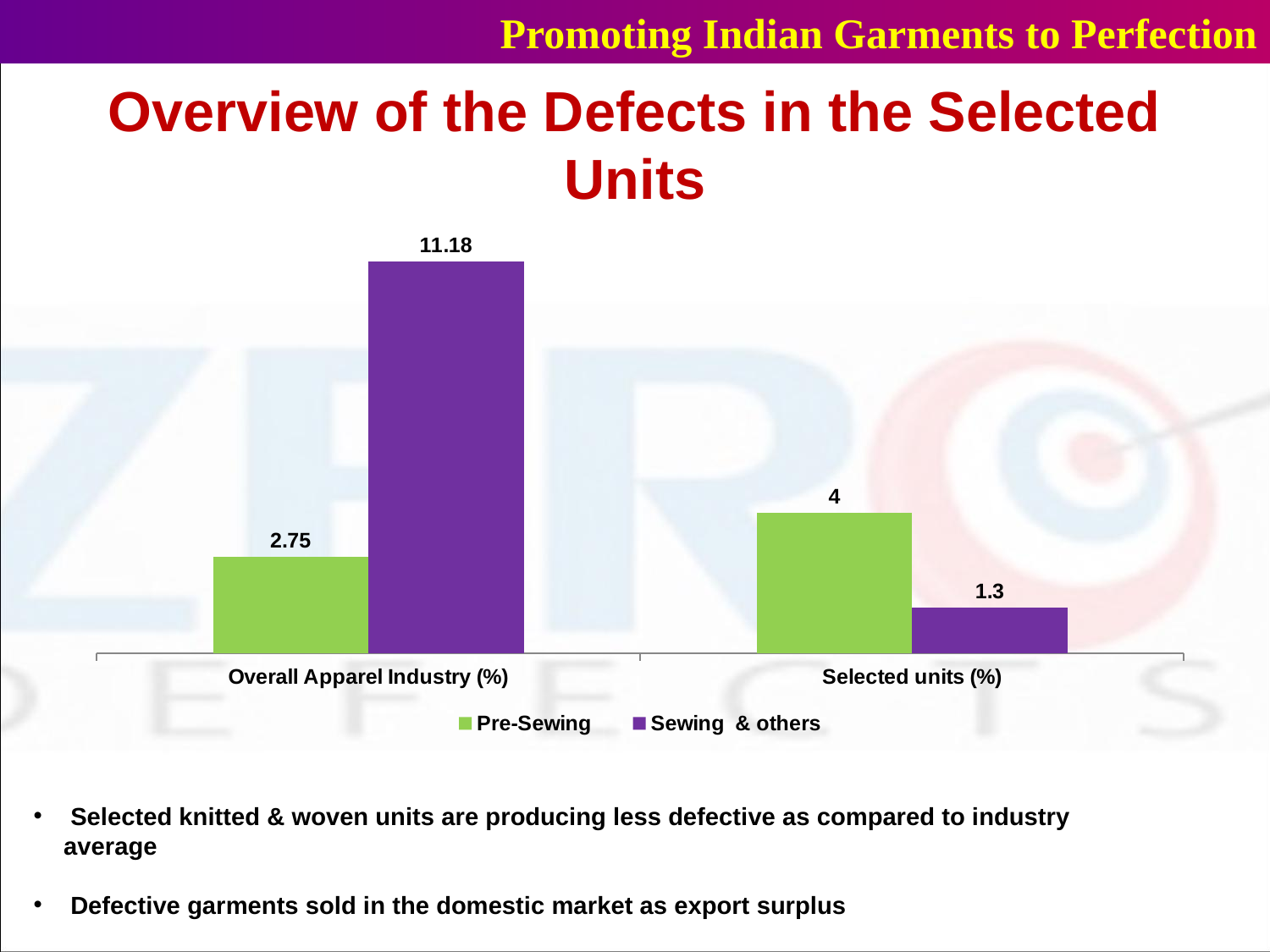
How many categories are shown on the x axis? 2 What is the Sewing & others value for Selected units (%)? 1.3 How many series does the legend list? 2 What colour are the Pre-Sewing bars? Green What is the Sewing & others value for Overall Apparel Industry (%)? 11.18 Which bar has the lowest value on the chart? Sewing & others for Selected units (%) What is the Pre-Sewing value for Selected units (%)? 4 What is the Pre-Sewing value for Overall Apparel Industry (%)? 2.75 What kind of chart is shown on the slide? Bar chart What is the difference between the Sewing & others values for Overall Apparel Industry (%) and Selected units (%)? 9.88 Which is larger: the Pre-Sewing value for Overall Apparel Industry (%) or for Selected units (%)? Selected units (%) Which bar has the highest value on the chart? Sewing & others for Overall Apparel Industry (%)